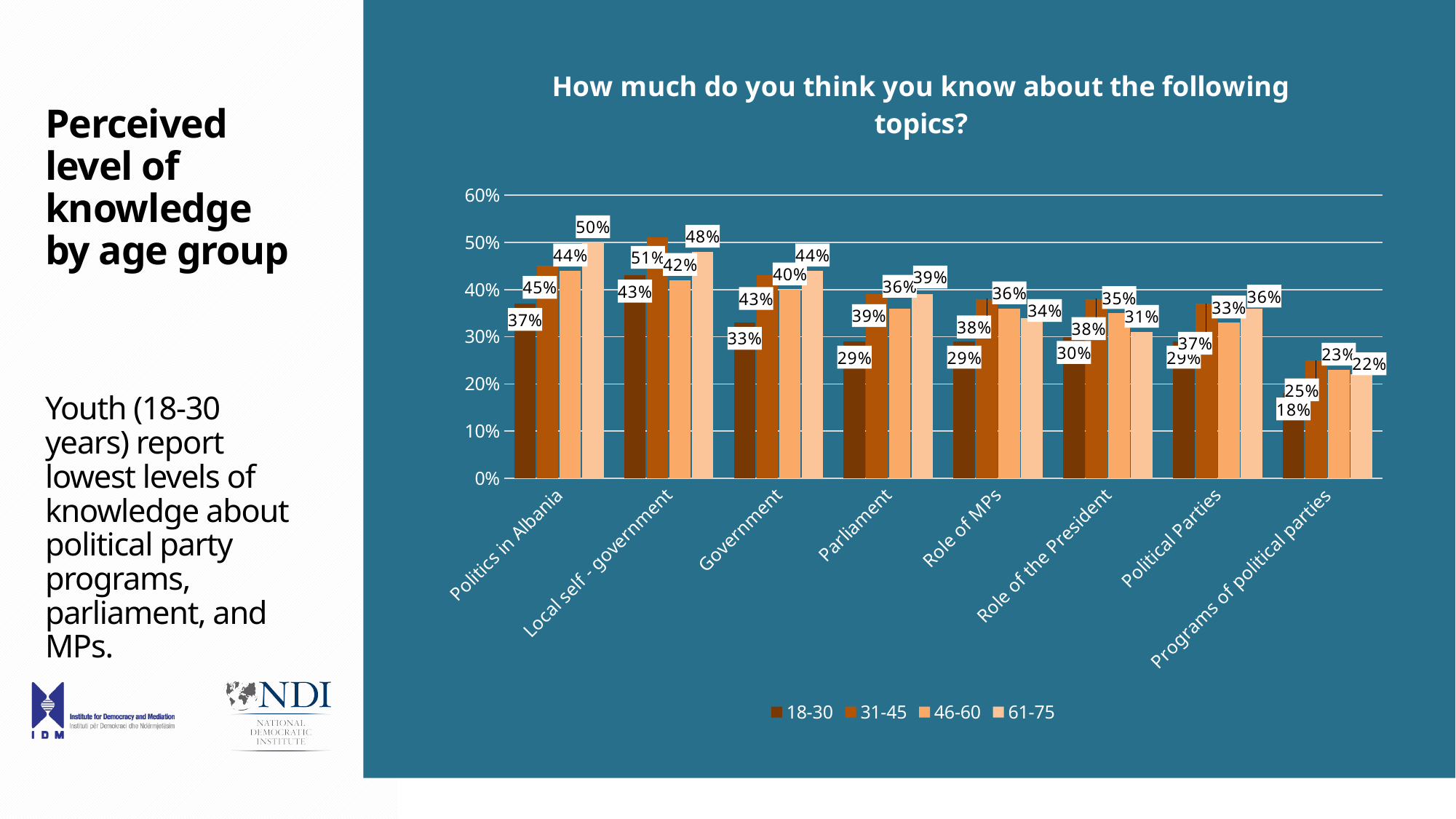
What is the value for the 46-60 age group for Role of the President? 35% How many topics are shown on the x axis? 8 What is the value for the 18-30 age group for Politics in Albania? 37% What is the value for the 31-45 age group for Programs of political parties? 25% Which topic has the highest value for the 31-45 age group? Local self - government What is the value for the 61-75 age group for Local self - government? 48% What kind of chart is shown on the slide? Bar chart Which topic has the lowest value for the 18-30 age group? Programs of political parties How many age groups does the legend list? 4 What is the title of the chart? How much do you think you know about the following topics? What is the difference between the 61-75 and 18-30 values for Politics in Albania? 13% For Government, which age group has the larger value, 31-45 or 46-60? 31-45